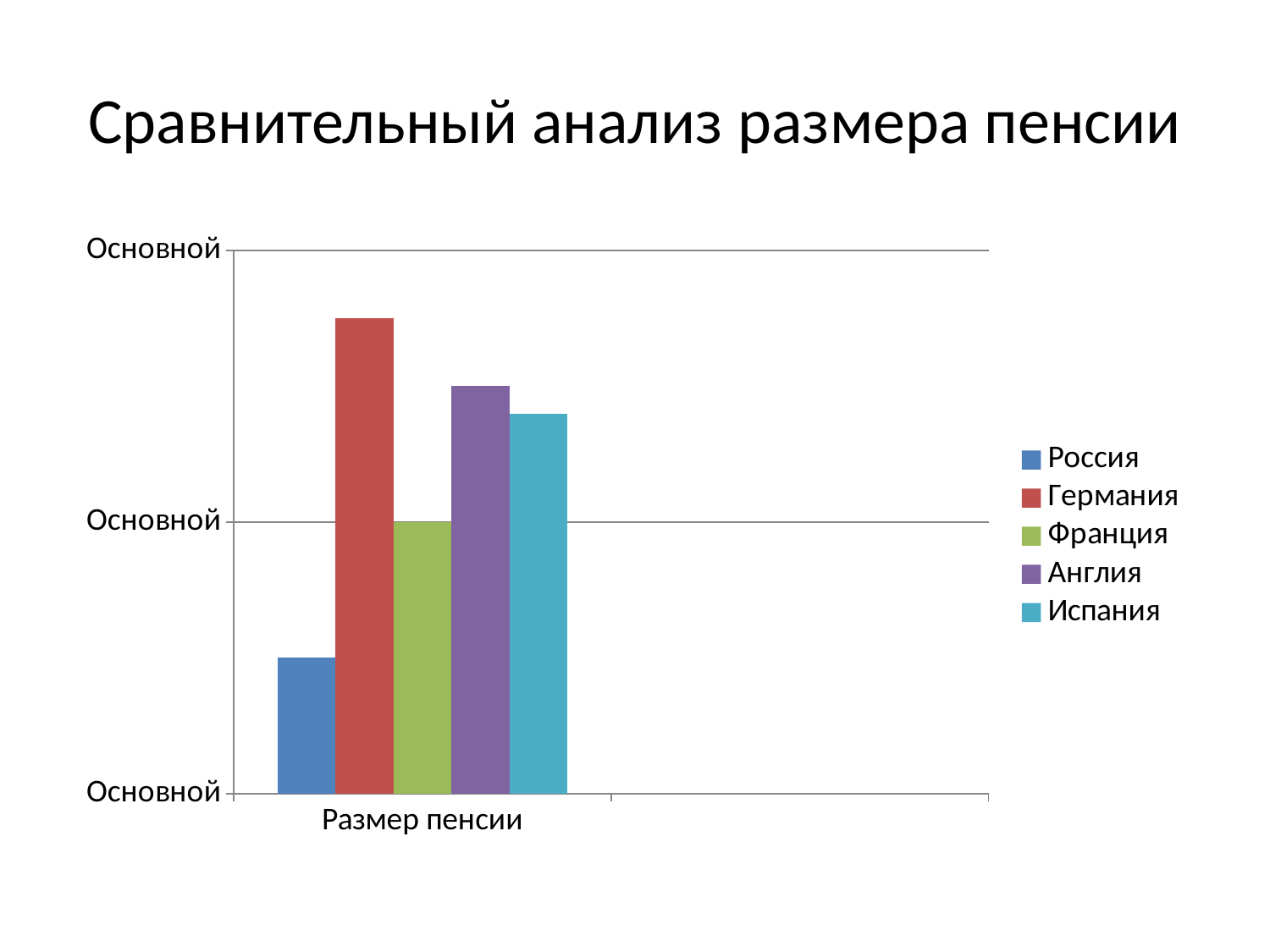
Which is larger, the bar for Россия or the bar for Франция? Франция Which is larger, the bar for Англия or the bar for Испания? Англия Which country has the lowest bar in the chart? Россия Which is larger, the bar for Франция or the bar for Испания? Испания What is the label of the category on the x axis? Размер пенсии What is the title of the slide's chart? Сравнительный анализ размера пенсии What kind of chart is shown on the slide? bar chart How many categories are shown on the x axis? 1 How many series does the legend list? 5 Which country has the highest bar in the chart? Германия